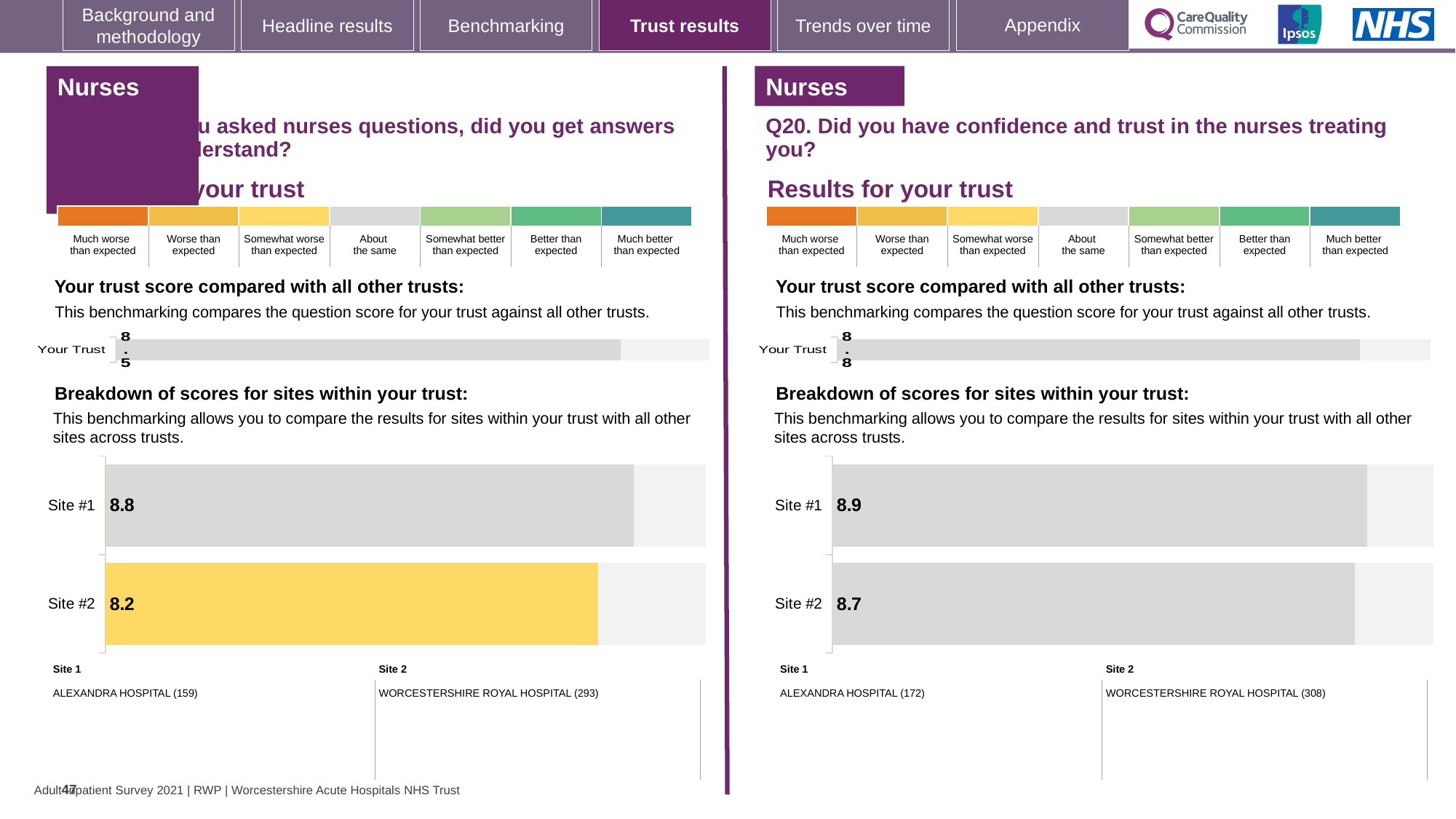
On the left-hand site breakdown chart, what is the difference between the Site #1 and Site #2 scores? 0.6 On the left-hand site breakdown chart, what is the score for Site #2? 8.2 On the Q20 (confidence and trust in nurses) site breakdown chart, what is the score for Site #1? 8.9 On the Q20 'Your trust score compared with all other trusts' chart, what is the score shown for Your Trust? 8.8 On the left-hand site breakdown chart, what is the score for Site #1? 8.8 On the left-hand site breakdown chart, which site has the higher score? Site #1 How many sites are shown on the Q20 site breakdown chart? 2 On the Q20 (confidence and trust in nurses) site breakdown chart, what is the score for Site #2? 8.7 What type of chart is used for the site breakdown on the left-hand side of the slide? Bar chart On the Q20 site breakdown chart, which site has the lower score? Site #2 On the left-hand 'Your trust score compared with all other trusts' chart, what is the score shown for Your Trust? 8.5 On the Q20 site breakdown chart, what is the difference between the Site #1 and Site #2 scores? 0.2